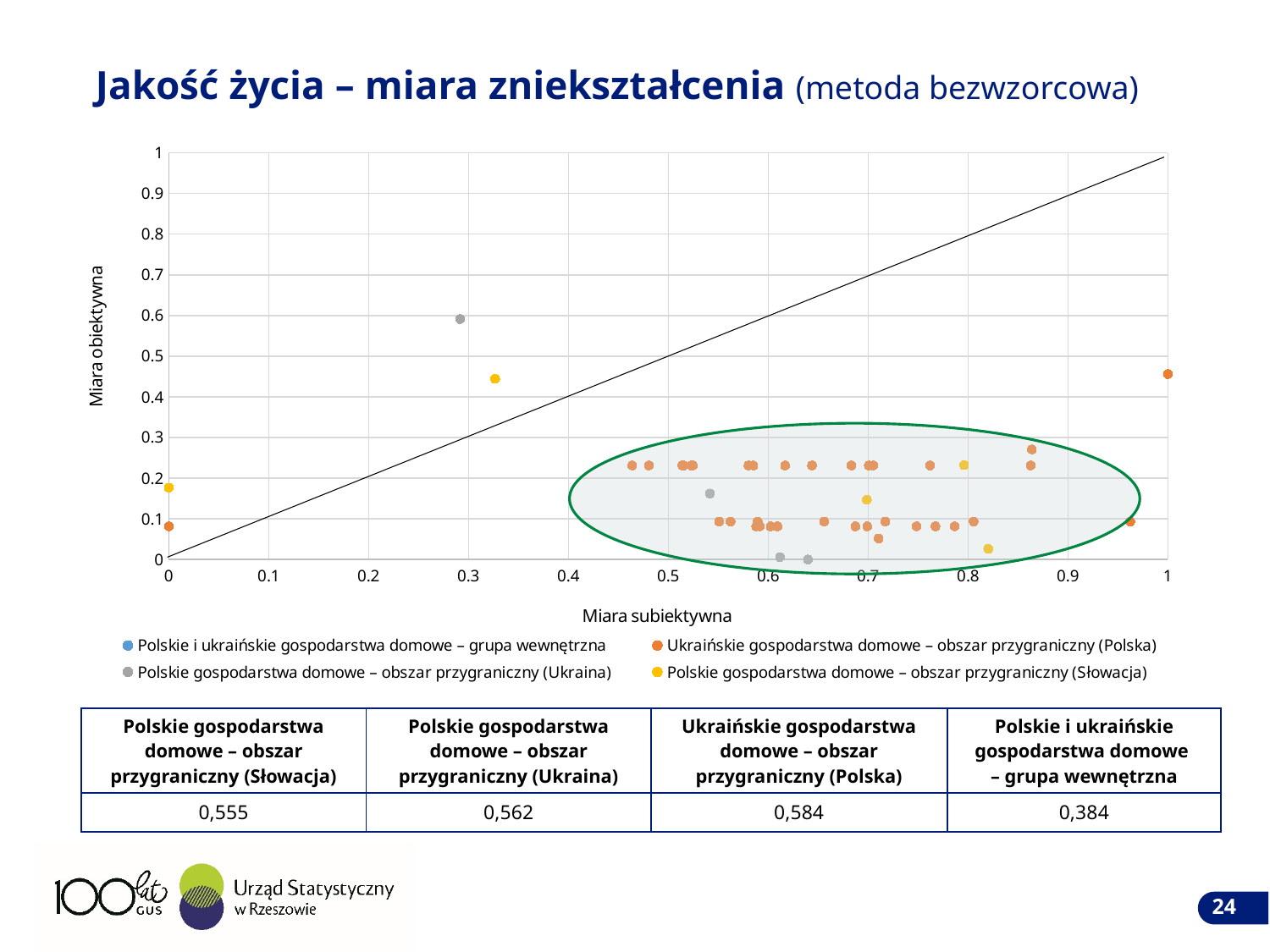
Is the Miara obiektywna value of the orange point plotted at Miara subiektywna 1 greater or less than 0.4? greater How many series does the chart legend list? 4 What is the title of the horizontal axis of the chart? Miara subiektywna What is the highest tick value shown on the vertical axis of the chart? 1 Is the Miara obiektywna value of the yellow point plotted near Miara subiektywna 0.33 greater or less than 0.6? less What kind of chart is shown on the slide? scatter chart Is the Miara obiektywna value of the yellow point plotted at Miara subiektywna 0 greater or less than 0.3? less Are most of the plotted points above or below the diagonal line on the chart? below Which series has the most points plotted on the chart? Ukraińskie gospodarstwa domowe – obszar przygraniczny (Polska) What is the title of the vertical axis of the chart? Miara obiektywna